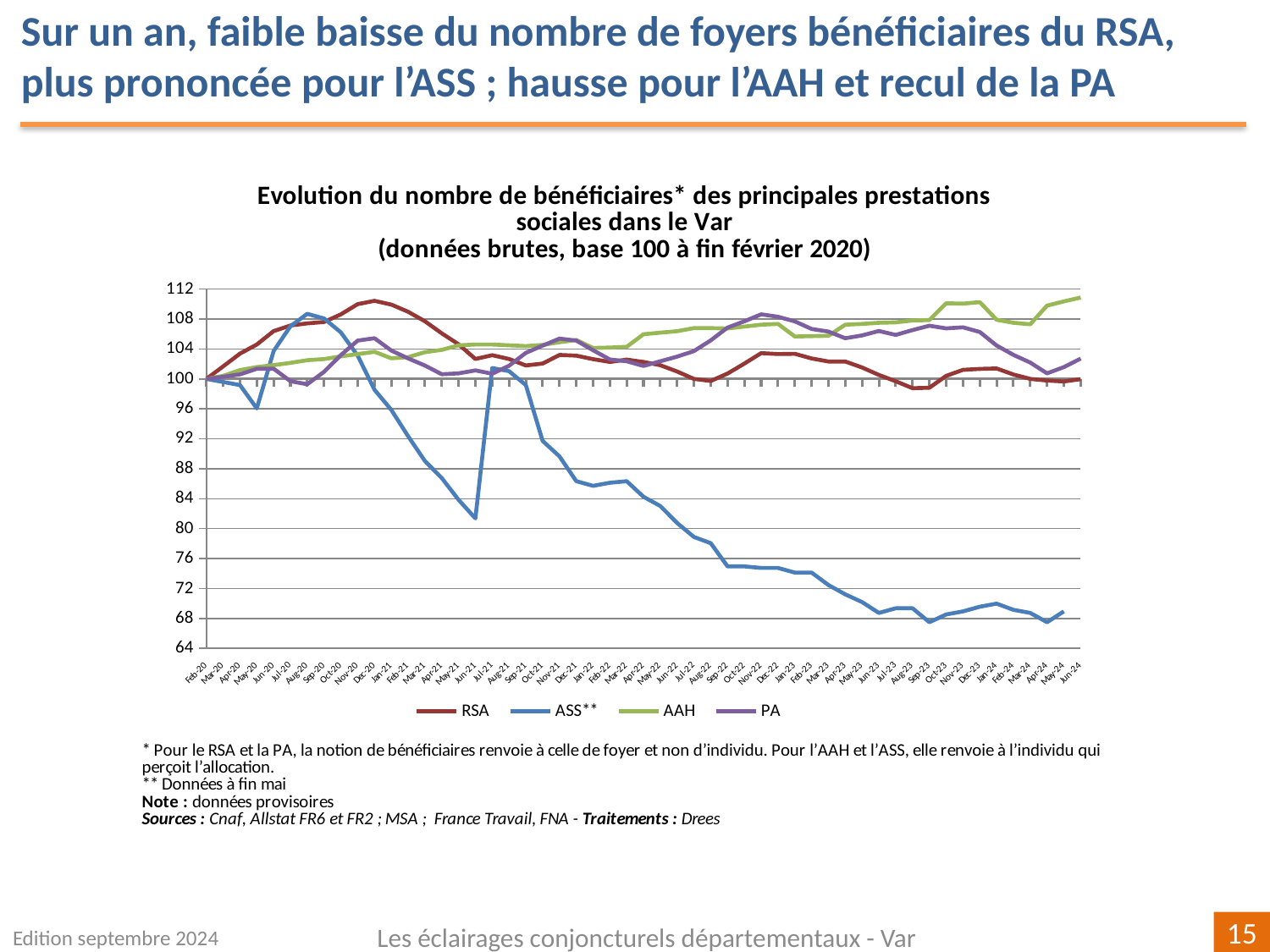
In Jun-24, which is larger, the value for AAH or the value for RSA? AAH According to the chart title, what is the base value of the index at the end of February 2020? 100 Is the value for RSA in Dec-20 greater or less than 108? greater How many series does the legend list? 4 Which series are listed in the legend? RSA, ASS**, AAH, PA Overall, does the AAH series rise or fall from Feb-20 to Jun-24? rise What kind of chart is shown on the slide? line chart Is the value for AAH in Jun-24 greater or less than 108? greater Which series has the lowest value in Jun-24? RSA Is the value for ASS** in Jun-21 greater or less than 84? less